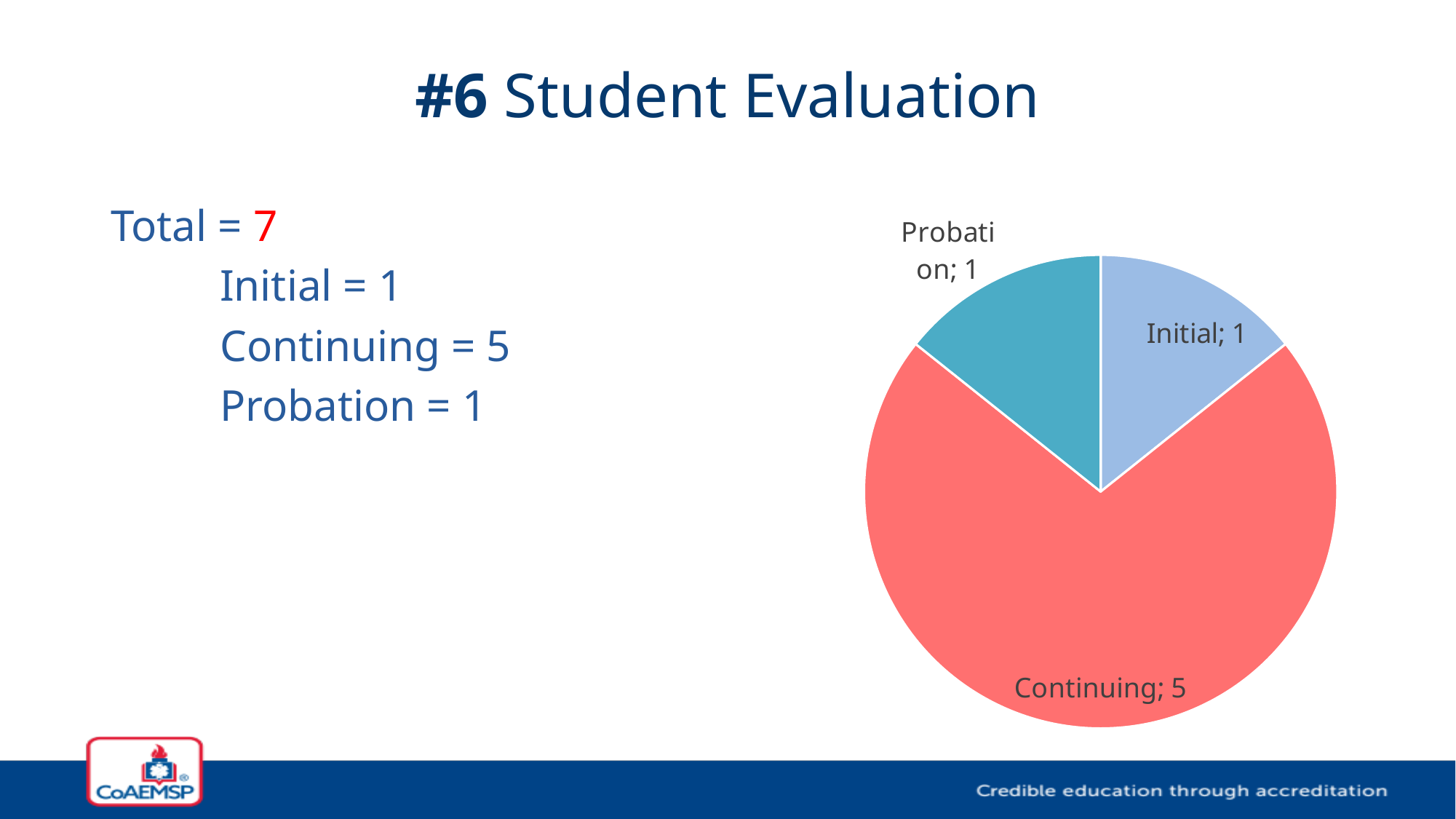
What is the difference between the Continuing and Initial values? 4 What colour is the Continuing slice in the pie chart? red What is the value for Initial in the pie chart? 1 What share of the pie does the Continuing slice represent? 5/7 What is the value for Probation in the pie chart? 1 What is the value for Continuing in the pie chart? 5 What kind of chart is shown on the slide? pie chart What is the title of the slide containing the pie chart? #6 Student Evaluation Which is larger, the value for Continuing or the value for Probation? Continuing How many slices does the pie chart have? 3 What is the total of all slices in the pie chart? 7 Which category has the largest slice in the pie chart? Continuing